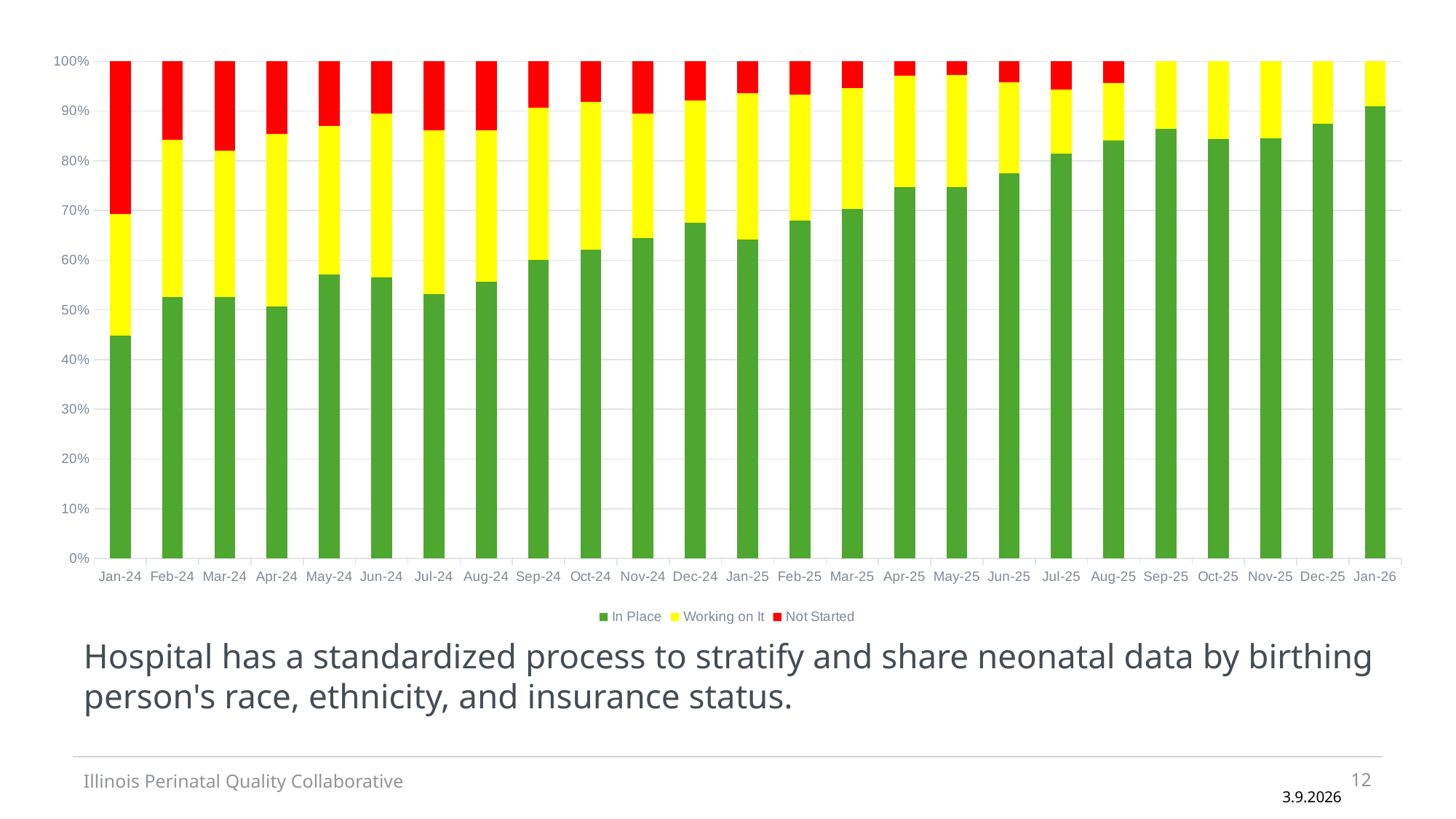
Which month has the largest Not Started share? Jan-24 Which month has the lowest In Place share? Jan-24 What kind of chart is shown on the slide? Stacked bar chart Is the Not Started value for Jan-24 greater or less than 20%? greater Is the In Place value for Jan-26 greater or less than 80%? greater How many months are plotted along the x axis? 25 Which colour represents the Working on It series? Yellow How many series does the legend list? 3 Which month has the highest In Place share? Jan-26 Which month has a larger In Place share, Jan-24 or Jan-26? Jan-26 Is the In Place value for Jan-24 greater or less than 50%? less Does the In Place share generally rise or fall from Jan-24 to Jan-26? Rise